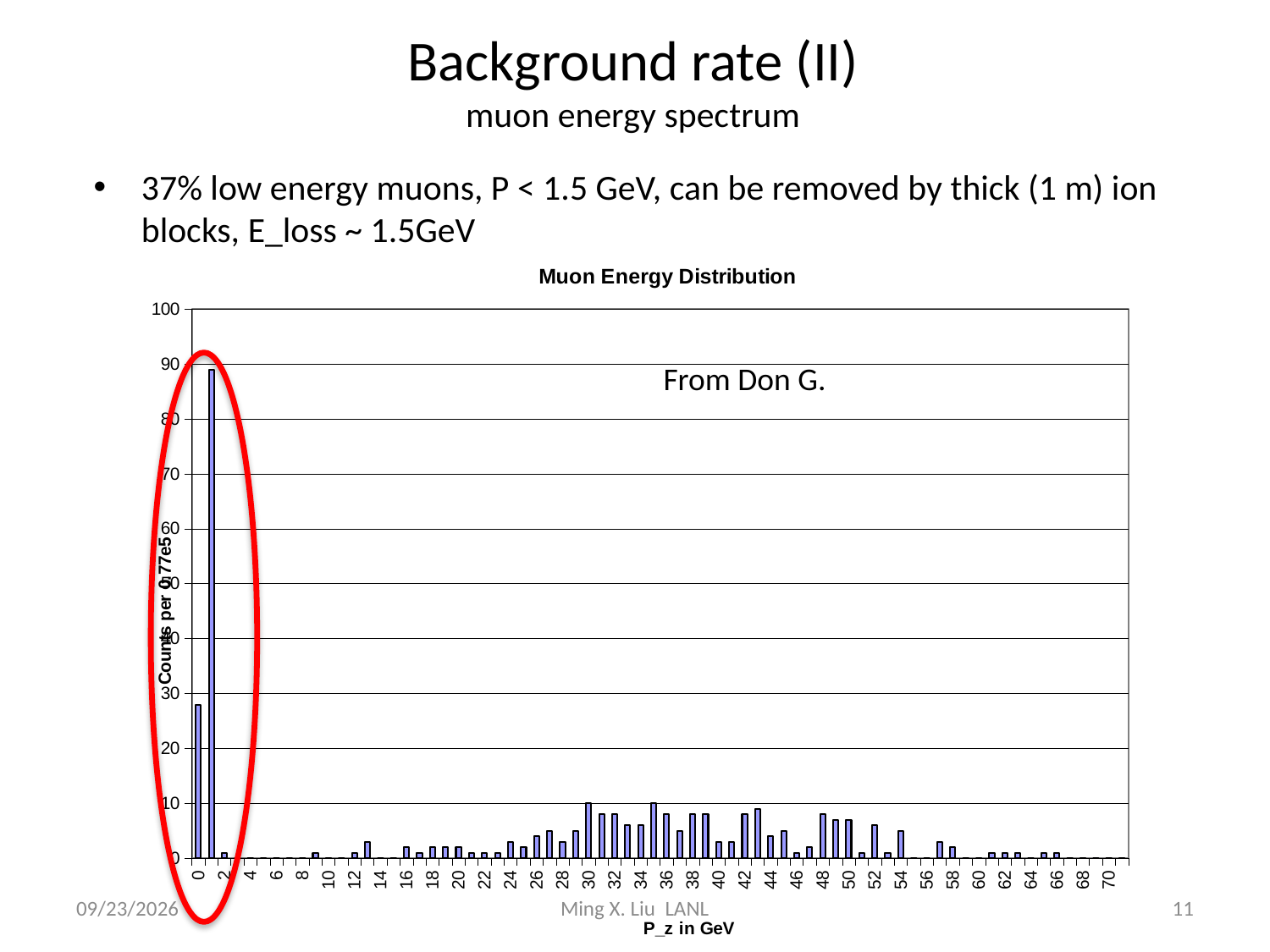
What kind of chart is shown on the slide? bar chart What is the title of the chart? Muon Energy Distribution Which has a larger count, P_z = 0 or P_z = 30? P_z = 0 Which has a larger count, P_z = 0 or P_z = 1? P_z = 1 Is the count for P_z = 1 greater or less than 80? greater What is the label of the x axis of the chart? P_z in GeV Is the count for P_z = 0 greater or less than 40? less Is the count for P_z = 30 greater or less than 20? less Which P_z value has the highest count in the chart? 1